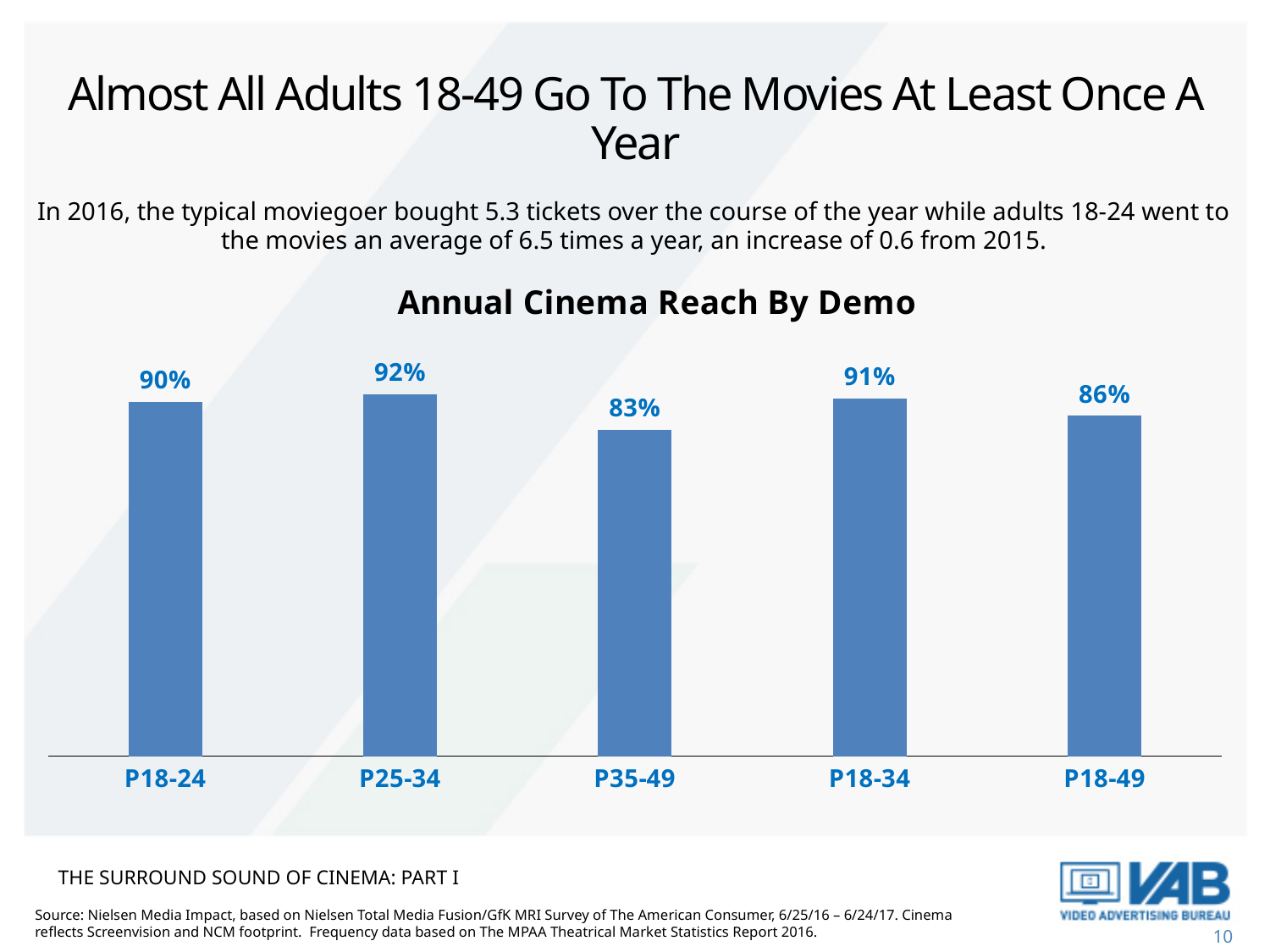
What is the annual cinema reach for P18-24? 90% What is the annual cinema reach for P35-49? 83% Which demo has the highest annual cinema reach? P25-34 Which has a higher annual cinema reach, P18-24 or P18-49? P18-24 What is the annual cinema reach for P18-49? 86% What is the difference in annual cinema reach between P18-34 and P18-49? 5% How many demo categories are shown in the chart? 5 What is the annual cinema reach for P18-34? 91% Which demo has the lowest annual cinema reach? P35-49 What is the title of the chart? Annual Cinema Reach By Demo What is the difference in annual cinema reach between P25-34 and P35-49? 9% What kind of chart is used to show annual cinema reach by demo? Bar chart